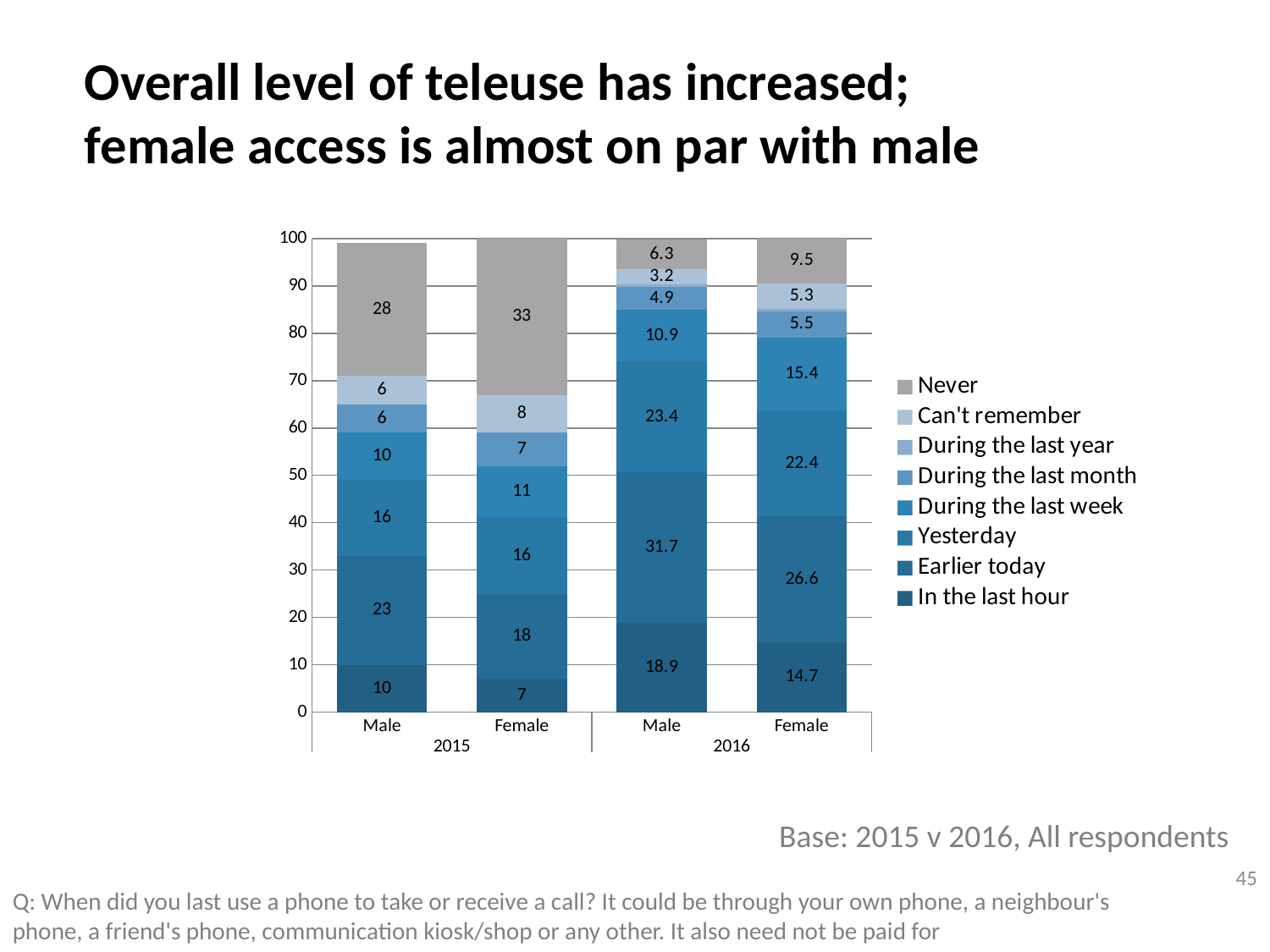
What is the difference between the 'Never' values for Male in 2015 and Male in 2016? 21.7 Which bar has the largest 'Never' segment? Female 2015 Which is larger, the 'Earlier today' value for Male in 2016 or for Female in 2016? Male 2016 Which bar has the smallest 'In the last hour' segment? Female 2015 What is the value of the 'Never' segment for Female in 2015? 33 What is the value of the 'Earlier today' segment for Female in 2016? 26.6 What kind of chart is shown on the slide? Stacked bar chart How many bars are plotted in the chart? 4 How many series does the legend list? 8 Which series is listed first (at the top) in the legend? Never What is the value of the 'In the last hour' segment for Male in 2016? 18.9 What is the value of the 'Yesterday' segment for Male in 2015? 16